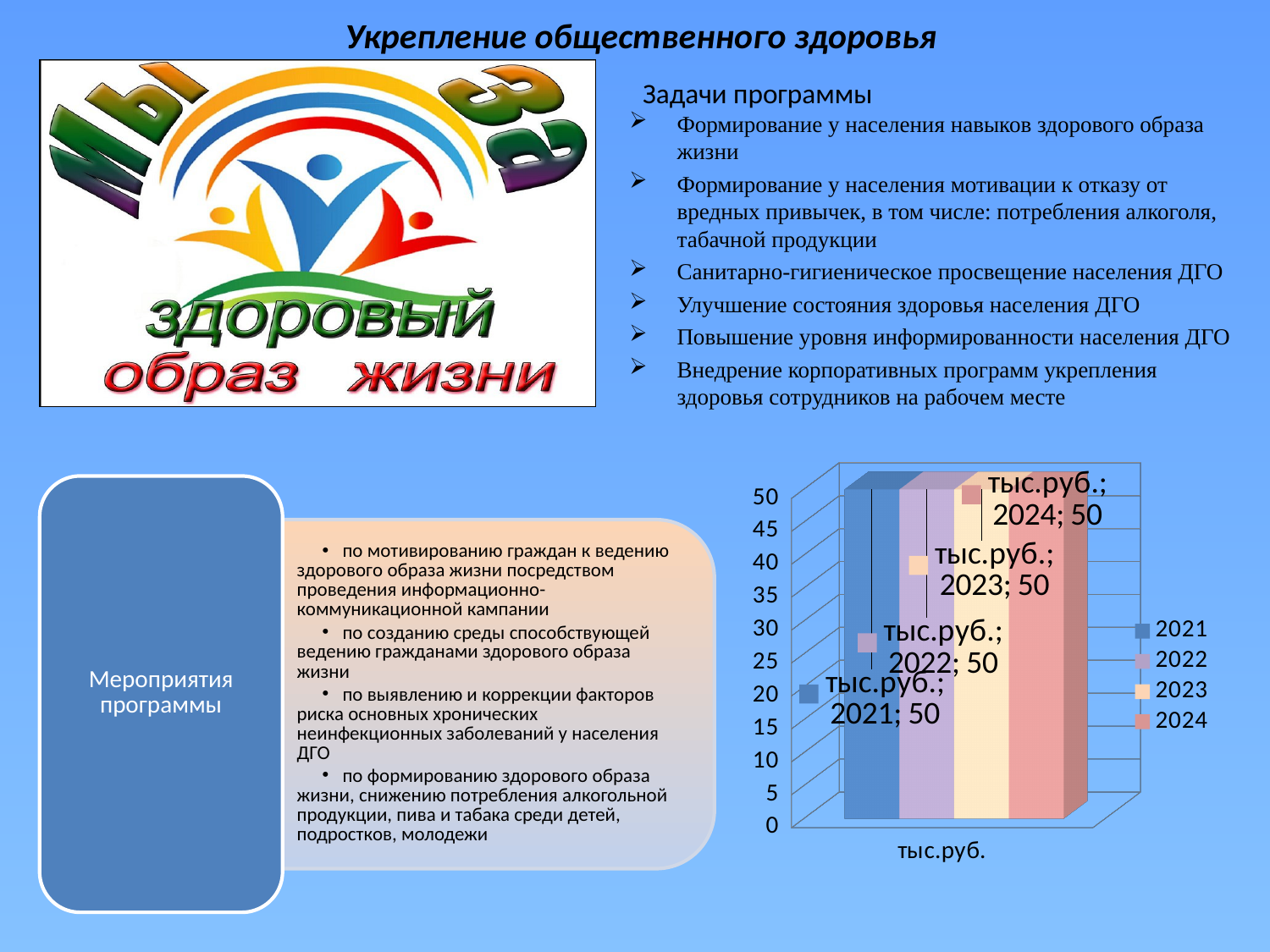
How many series does the chart legend list? 4 What kind of chart is shown on the slide? bar chart Is the value for 2023 greater or less than 45? greater What is the value for 2023 in the chart? 50 What is the value for 2021 in the chart? 50 What is the value for 2024 in the chart? 50 Which series is listed first in the chart legend? 2021 How many categories are shown on the x axis of the chart? 1 What is the difference between the values for 2024 and 2021? 0 Do the values change across the series from 2021 to 2024? No, they stay the same What is the value for 2022 in the chart? 50 What is the category label shown on the x axis of the chart? тыс.руб.